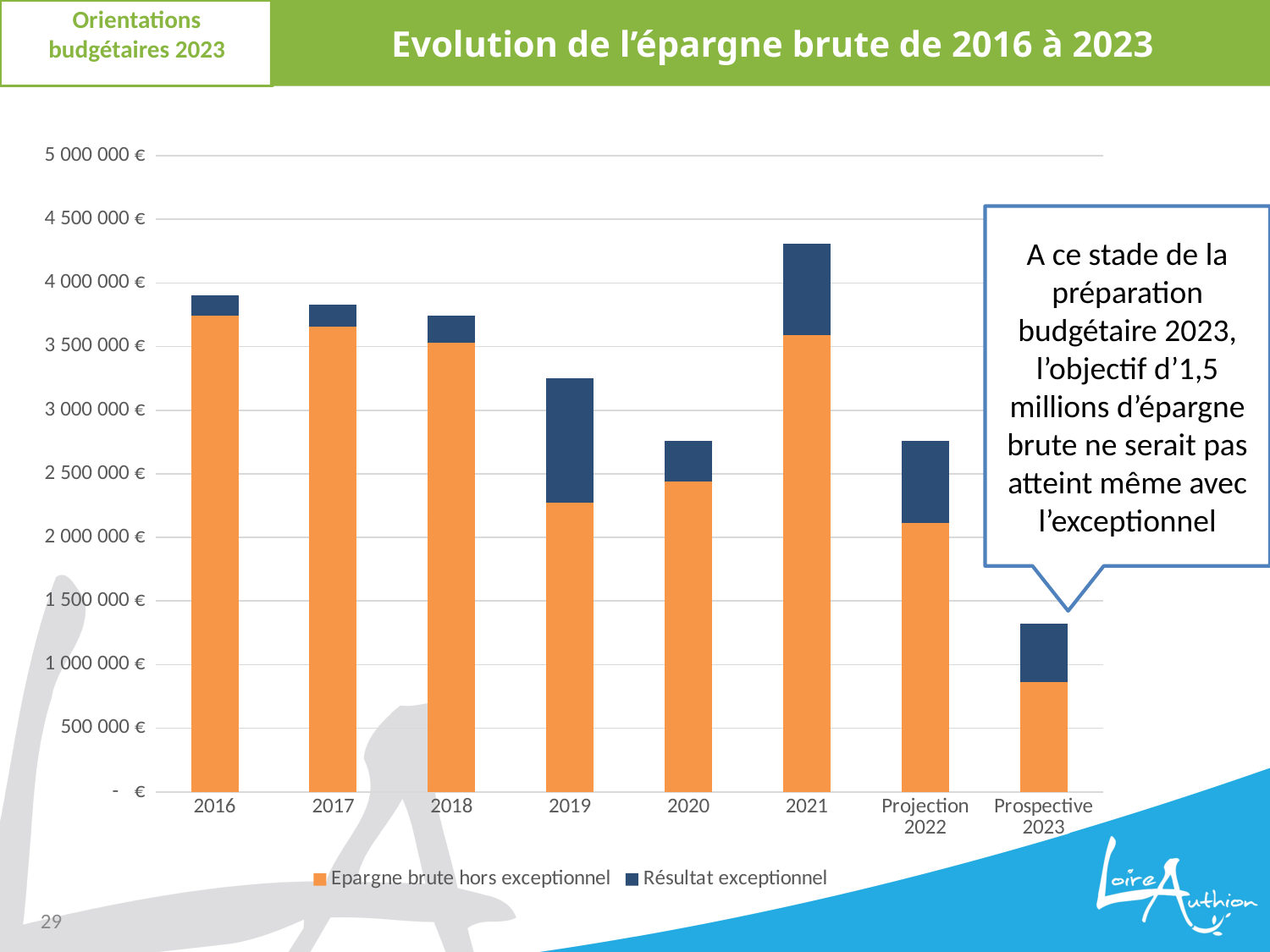
Which is larger: the Epargne brute hors exceptionnel value for 2016 or for 2019? 2016 Is the Epargne brute hors exceptionnel value for 2019 greater or less than 2 500 000 €? less Which category has the highest value for Epargne brute hors exceptionnel? 2016 What kind of chart is shown on the slide? Stacked bar chart Is the total bar for 2021 greater or less than 4 000 000 €? greater Which category has the highest total bar (Epargne brute hors exceptionnel plus Résultat exceptionnel)? 2021 Is the total bar for Prospective 2023 greater or less than 1 500 000 €? less What colour represents the Résultat exceptionnel series in the chart? Dark blue How many series does the chart legend list? 2 Does the Epargne brute hors exceptionnel value rise or fall from 2016 to 2018? fall How many categories are shown on the x axis of the chart? 8 Which category has the lowest total bar? Prospective 2023